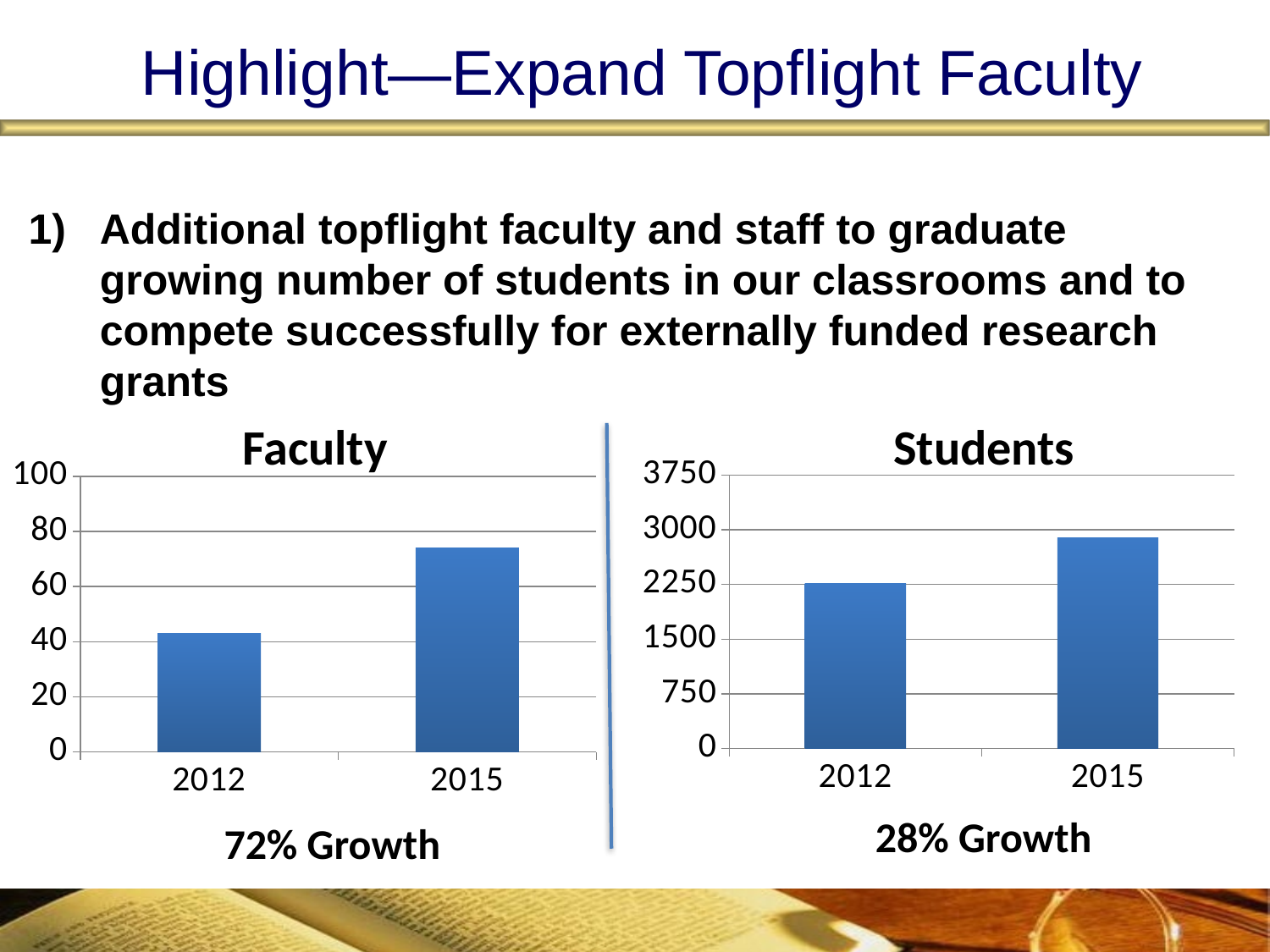
What type of chart is the Faculty chart? bar chart In the Students chart, is the value for 2012 greater or less than 1500? greater In the Faculty chart, is the value for 2012 greater or less than 40? greater How many bars are shown in the Faculty chart? 2 In the Students chart, is the value for 2015 greater or less than 3000? less In the Students chart, which year has the higher value? 2015 In the Faculty chart, which year has the lower value? 2012 What type of chart is the Students chart? bar chart In the Faculty chart, which year has the higher value? 2015 Do the values in the Students chart rise or fall from 2012 to 2015? rise What growth percentage is stated below the Faculty chart? 72% Growth